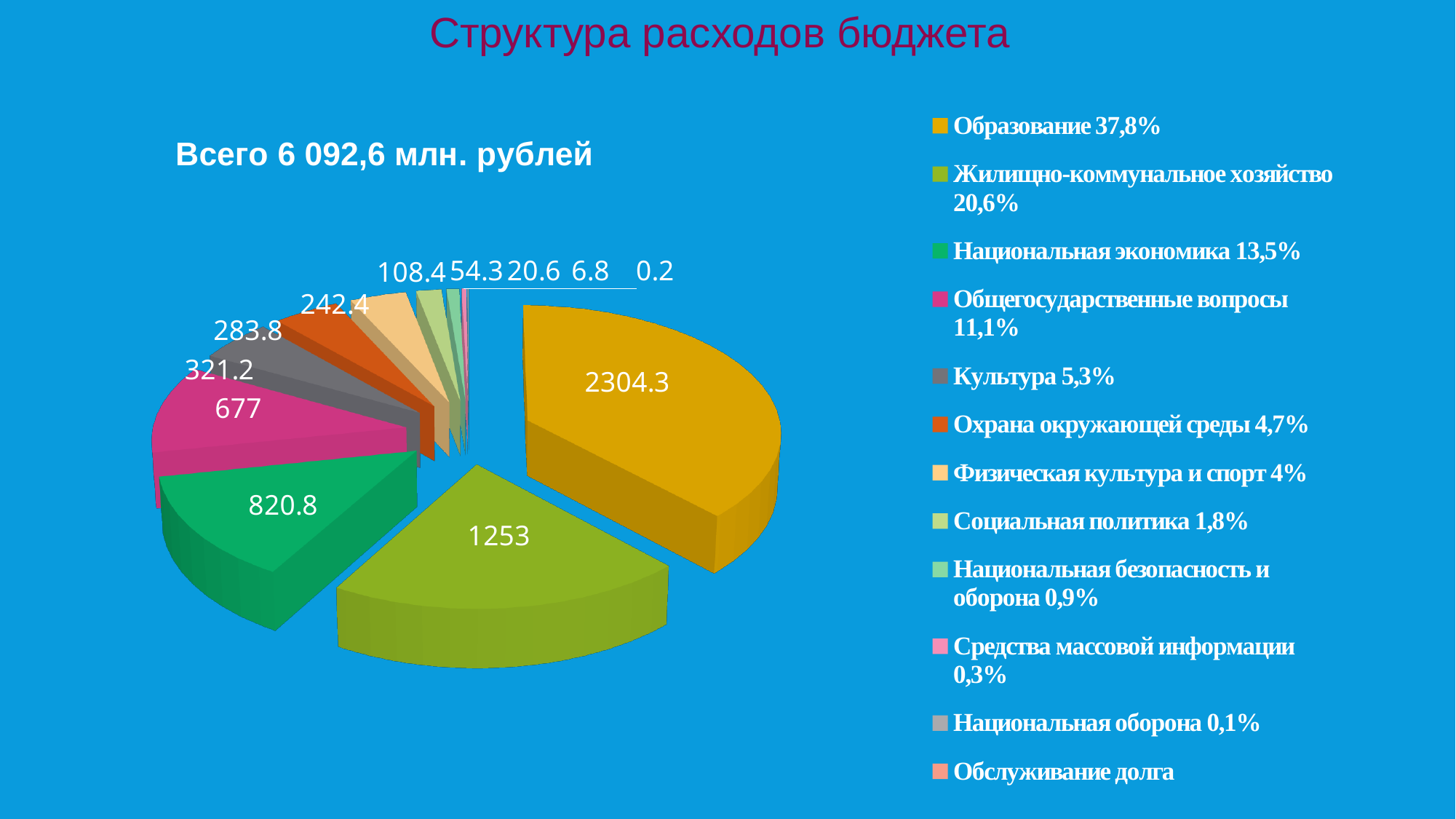
What is the value for Жилищно-коммунальное хозяйство? 1253 Which category has the smallest slice of the pie? Обслуживание долга What is the value for Общегосударственные вопросы? 677 How many categories does the legend list? 12 Which is larger, the value for Культура or the value for Охрана окружающей среды? Культура What share of the pie does Национальная экономика represent, according to the legend? 13,5% Which category has the largest slice of the pie? Образование What is the value for Образование? 2304.3 What kind of chart is shown on the slide? Pie chart What total amount is stated above the chart? Всего 6 092,6 млн. рублей What is the value for Национальная экономика? 820.8 What is the difference between the values for Образование and Жилищно-коммунальное хозяйство? 1051.3